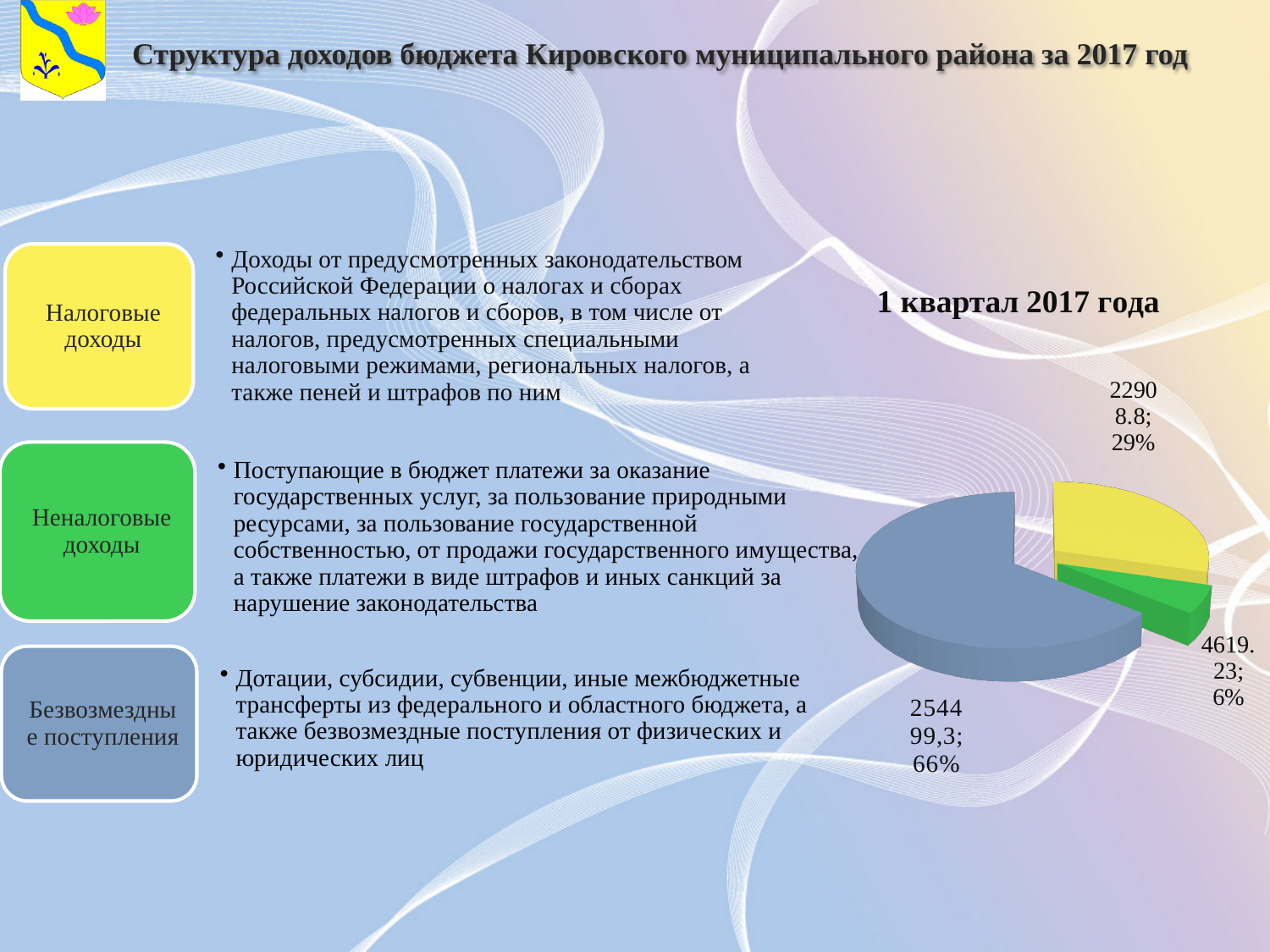
What value is labelled on the green slice of the pie chart? 4619.23 How many slices does the pie chart have? 3 By how many percentage points does the blue slice's share exceed the yellow slice's share? 37 percentage points What kind of chart is shown on the slide? pie chart What is the title of the pie chart? 1 квартал 2017 года What percentage share is shown for the yellow slice of the pie chart? 29% Which slice of the pie chart has the largest share? the blue slice (66%) What percentage share is shown for the green slice of the pie chart? 6% Which slice of the pie chart has the smallest share? the green slice (6%) Which slice is larger in the pie chart, the yellow one or the green one? the yellow one What percentage share is shown for the blue slice of the pie chart? 66% What colour is the slice labelled 66% in the pie chart? blue